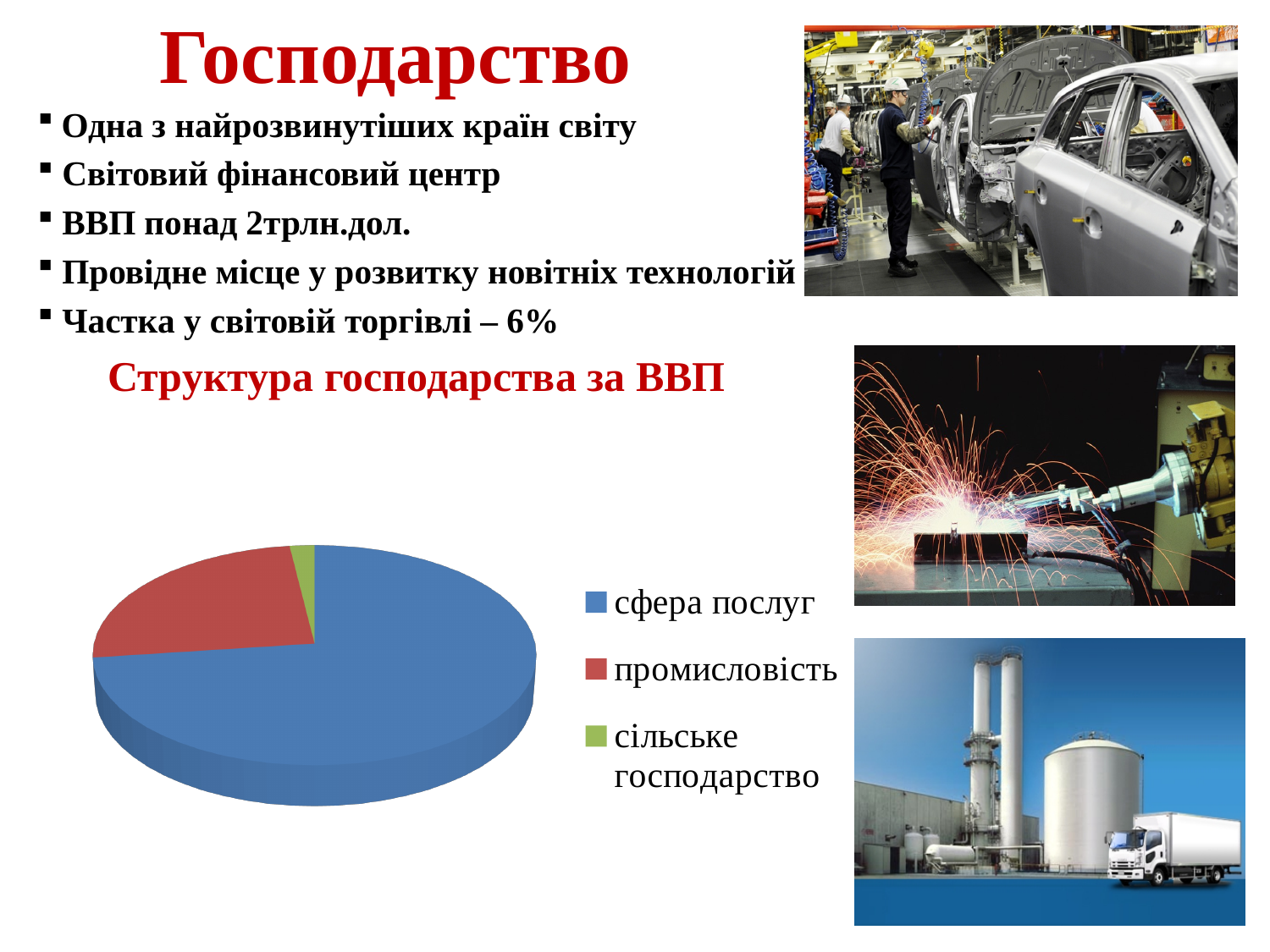
What is the title shown above the pie chart? Структура господарства за ВВП Which slice is larger in the pie chart, промисловість or сільське господарство? промисловість How many slices does the pie chart have? 3 What kind of chart is shown on the slide? pie chart Which category has the smallest slice in the pie chart? сільське господарство How many entries does the legend of the pie chart list? 3 Which slice is larger in the pie chart, сфера послуг or промисловість? сфера послуг What colour is the slice for промисловість in the pie chart? red Which category has the largest slice in the pie chart? сфера послуг